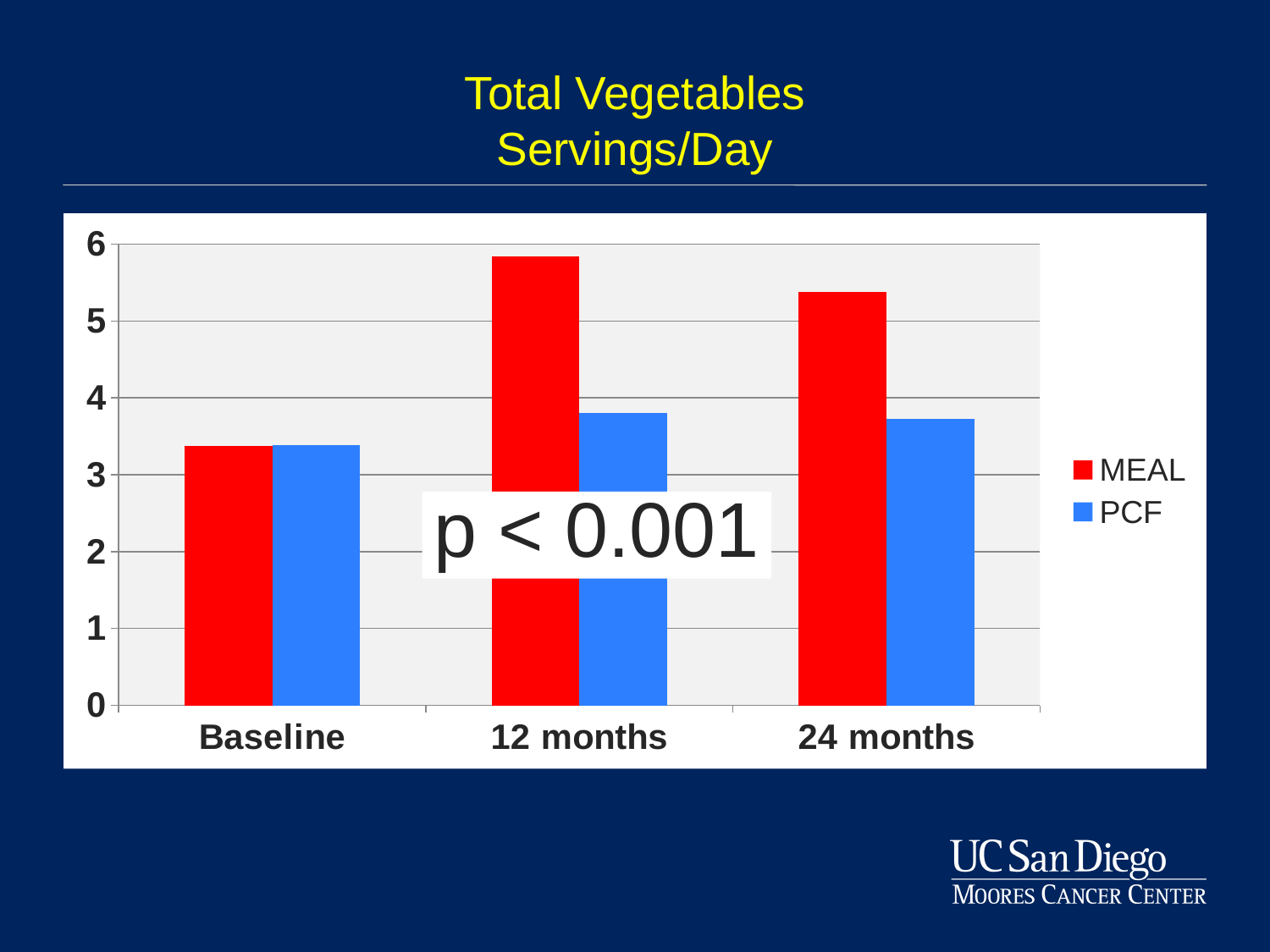
At 24 months, which series has the larger value, MEAL or PCF? MEAL How many categories are shown on the x axis? 3 Which is larger: the MEAL value at 12 months or the MEAL value at 24 months? 12 months Is the PCF value at Baseline greater or less than 3? greater What is the title of the chart? Total Vegetables Servings/Day At which time point is the MEAL value lowest? Baseline Is the PCF value at 12 months greater or less than 4? less At which time point is the MEAL value highest? 12 months Is the MEAL value at 12 months greater or less than 5? greater What kind of chart is shown on the slide? bar chart How many series does the legend list? 2